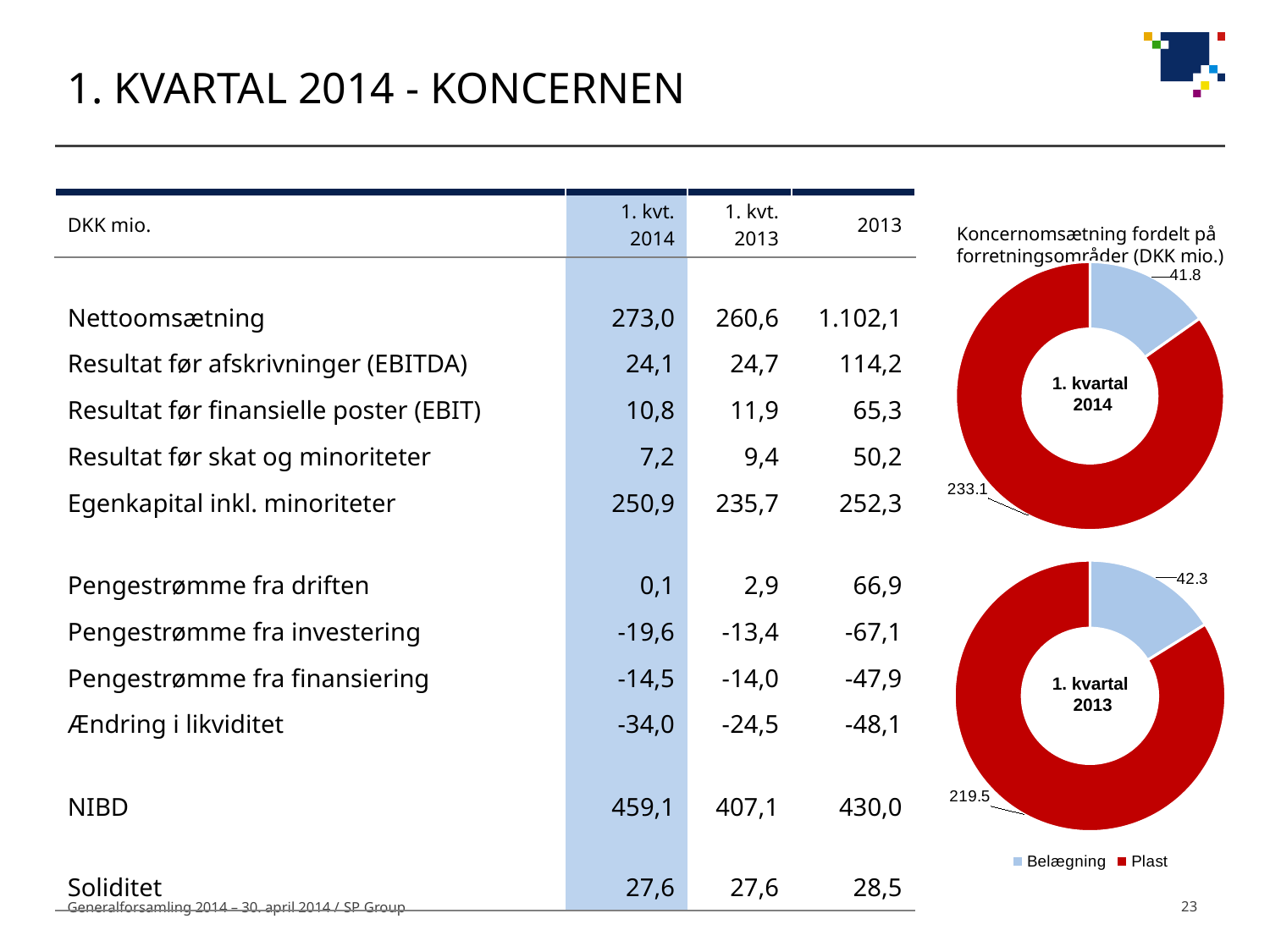
Comparing the two doughnut charts, is the Plast value larger in 1. kvartal 2014 or 1. kvartal 2013? 1. kvartal 2014 What is the total of the two segments in the 1. kvartal 2013 doughnut chart? 261.8 In the 1. kvartal 2014 doughnut chart, what is the value for Belægning? 41.8 In the 1. kvartal 2014 doughnut chart, what is the difference between Plast and Belægning? 191.3 In the 1. kvartal 2013 doughnut chart, which business area has the smallest share? Belægning What kind of chart is used to show the revenue split by business area? Doughnut chart What colour represents Plast in the doughnut charts? Red In the 1. kvartal 2014 doughnut chart, what is the value for Plast? 233.1 How many series does the legend of the doughnut charts list? 2 In the 1. kvartal 2013 doughnut chart, what is the value for Belægning? 42.3 In the 1. kvartal 2013 doughnut chart, what is the value for Plast? 219.5 In the 1. kvartal 2014 doughnut chart, which business area has the largest share? Plast